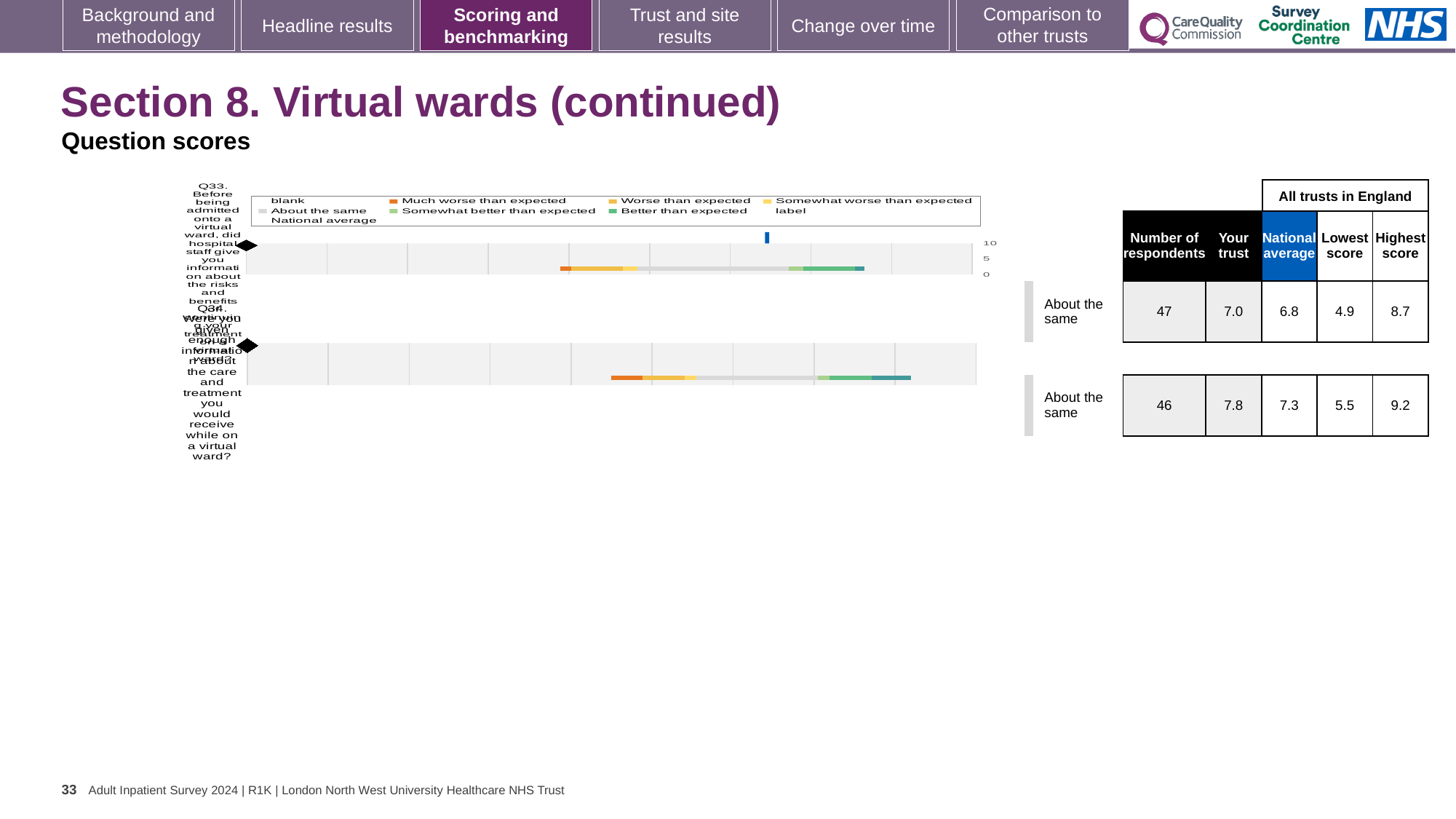
What is the national average score for Q34? 7.3 Which question has the higher 'Your trust' score, Q33 or Q34? Q34 For Q33, which is larger: the 'Your trust' score or the national average? Your trust What kind of chart is used to show the question scores on this slide? Bar chart What is the number of respondents for Q33? 47 What is the difference between the 'Your trust' score and the national average for Q33? 0.2 What is the highest score among all trusts in England for Q33? 8.7 What is the 'Your trust' score for Q34? 7.8 How many questions are plotted in the chart? 2 What benchmark category is shown for Q34? About the same What is the difference between the highest score and the lowest score for Q34? 3.7 What is the 'Your trust' score for Q33? 7.0